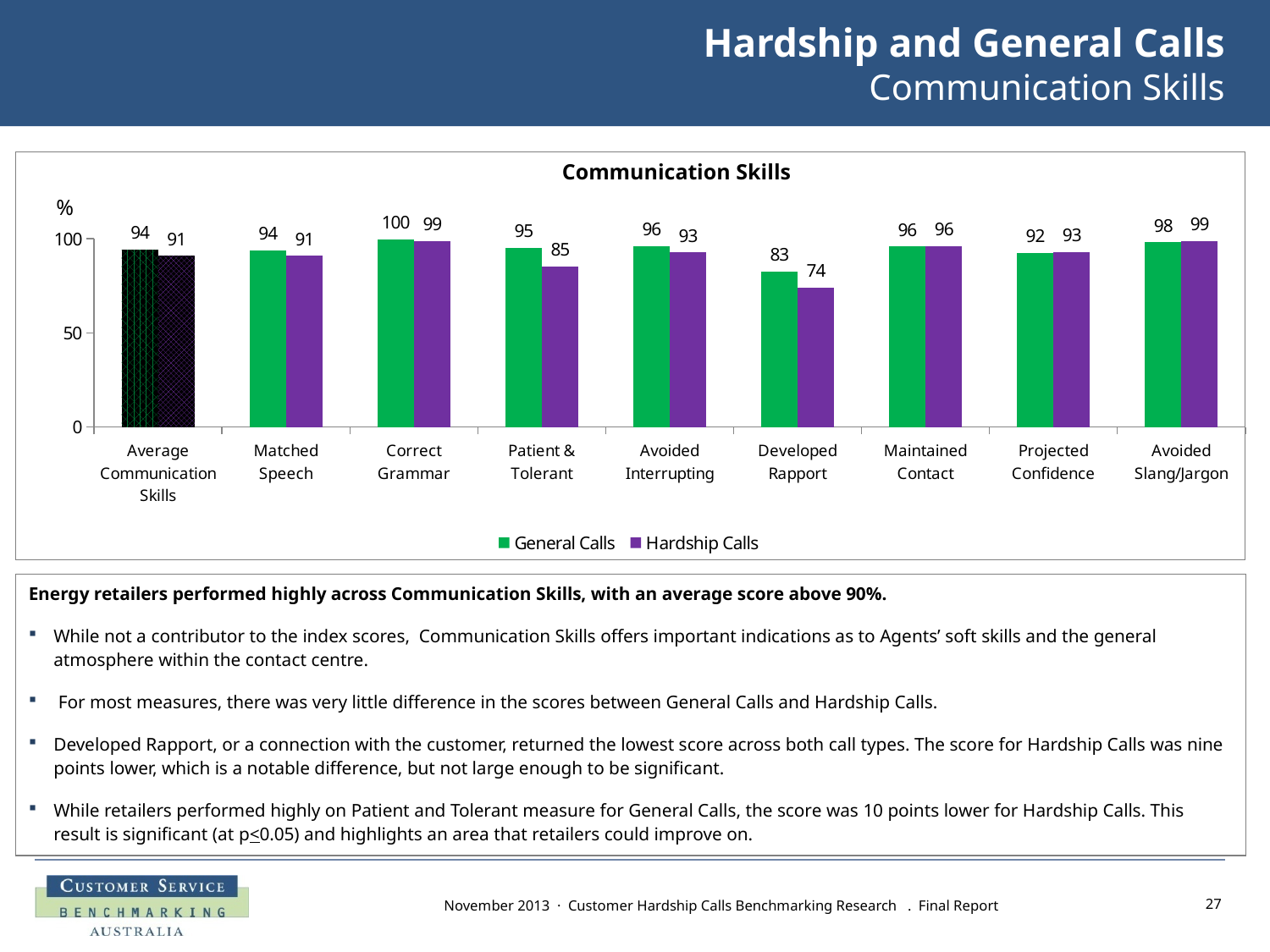
Is the Hardship Calls value for Developed Rapport greater or less than 50? greater What is the Hardship Calls value for Developed Rapport? 74 What kind of chart is shown? Bar chart For Avoided Slang/Jargon, which is larger: the General Calls value or the Hardship Calls value? Hardship Calls Which category has the highest General Calls value? Correct Grammar How many series does the legend list? 2 What is the Hardship Calls value for Patient & Tolerant? 85 What is the difference between the General Calls and Hardship Calls values for Developed Rapport? 9 What is the difference between the General Calls and Hardship Calls values for Patient & Tolerant? 10 What is the General Calls value for Correct Grammar? 100 How many categories are shown on the x axis? 9 Which category has the lowest General Calls value? Developed Rapport